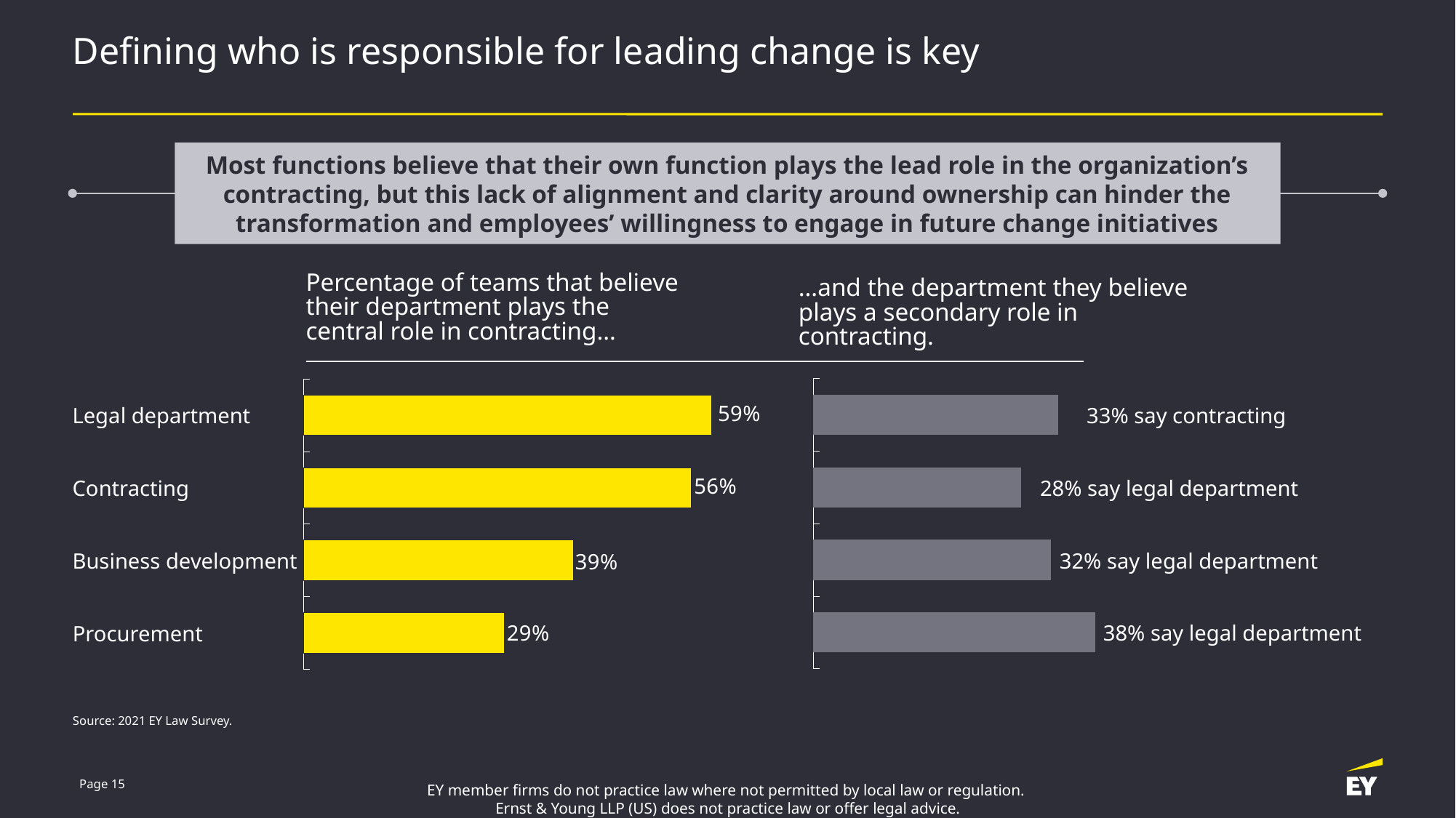
How many categories are shown in the left chart (central role in contracting)? 4 In the left chart (central role in contracting), which category has the lowest value? Procurement In the left chart (central role in contracting), what is the difference between the values for Legal department and Contracting? 3% In the left chart (central role in contracting), which is larger, the value for Business development or the value for Procurement? Business development In the right chart (secondary role in contracting), what percentage of the Contracting team say legal department plays a secondary role? 28% In the left chart (central role in contracting), which category has the highest value? Legal department What kind of chart is the left chart (central role in contracting)? Bar chart In the left chart (central role in contracting), what is the value for Procurement? 29% In the right chart (secondary role in contracting), which category has the highest value? Procurement In the right chart (secondary role in contracting), which department do 33% of the Legal department say plays a secondary role? Contracting In the left chart (central role in contracting), what is the value for Business development? 39% In the left chart (percentage of teams that believe their department plays the central role in contracting), what is the value for Legal department? 59%